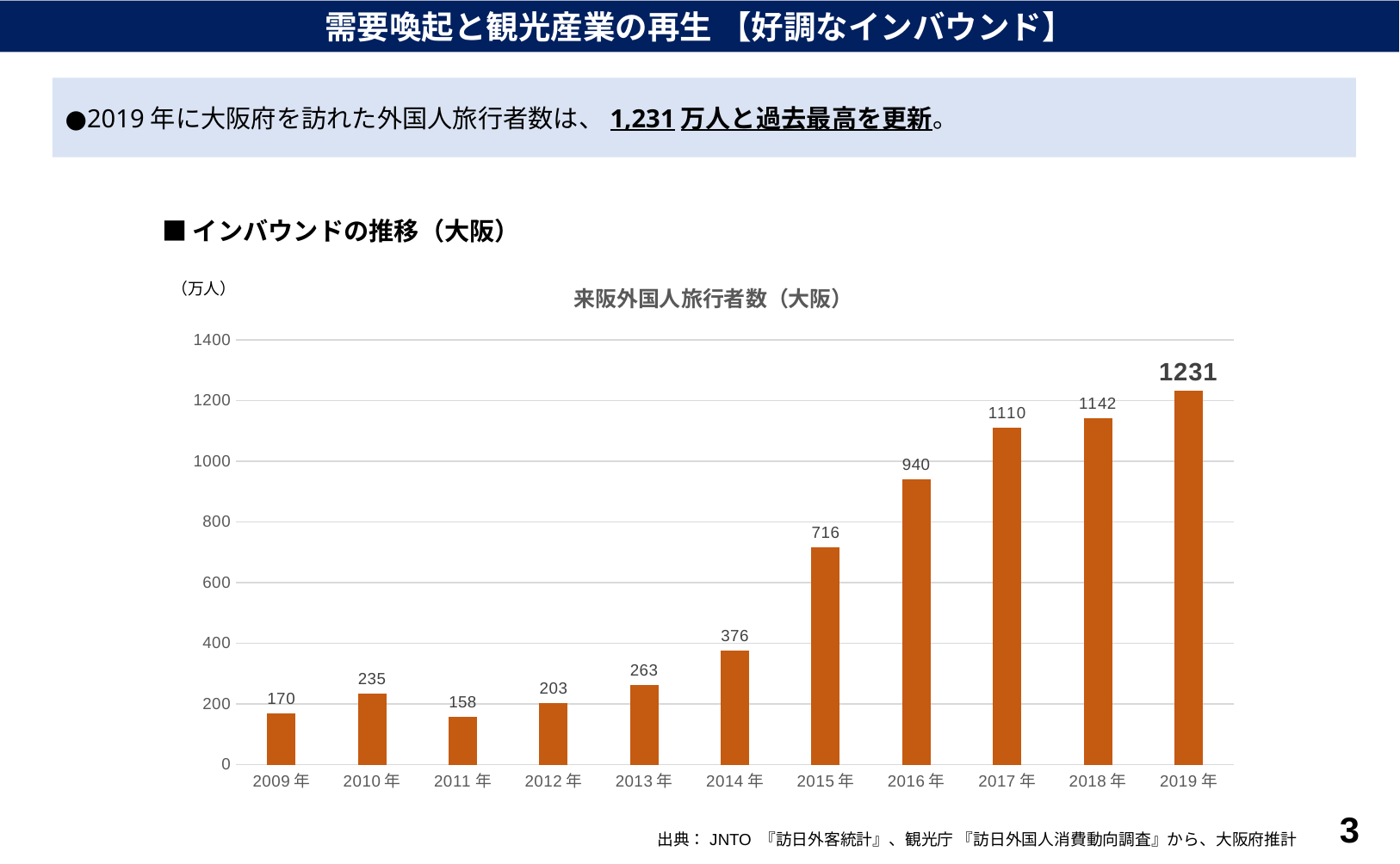
What is the value for 2015年 in the chart? 716 What is the title of the chart? 来阪外国人旅行者数（大阪） What is the value for 2019年 in the chart? 1231 Is the value for 2017年 greater or less than 1000? greater Which is larger, the value for 2010年 or the value for 2012年? 2010年 What is the difference between the values for 2016年 and 2015年? 224 What kind of chart is shown on the slide? bar chart Which year has the lowest value in the chart? 2011年 How many years are shown on the x axis of the chart? 11 What is the value for 2011年 in the chart? 158 Which year has the highest value in the chart? 2019年 What is the difference between the values for 2019年 and 2018年? 89